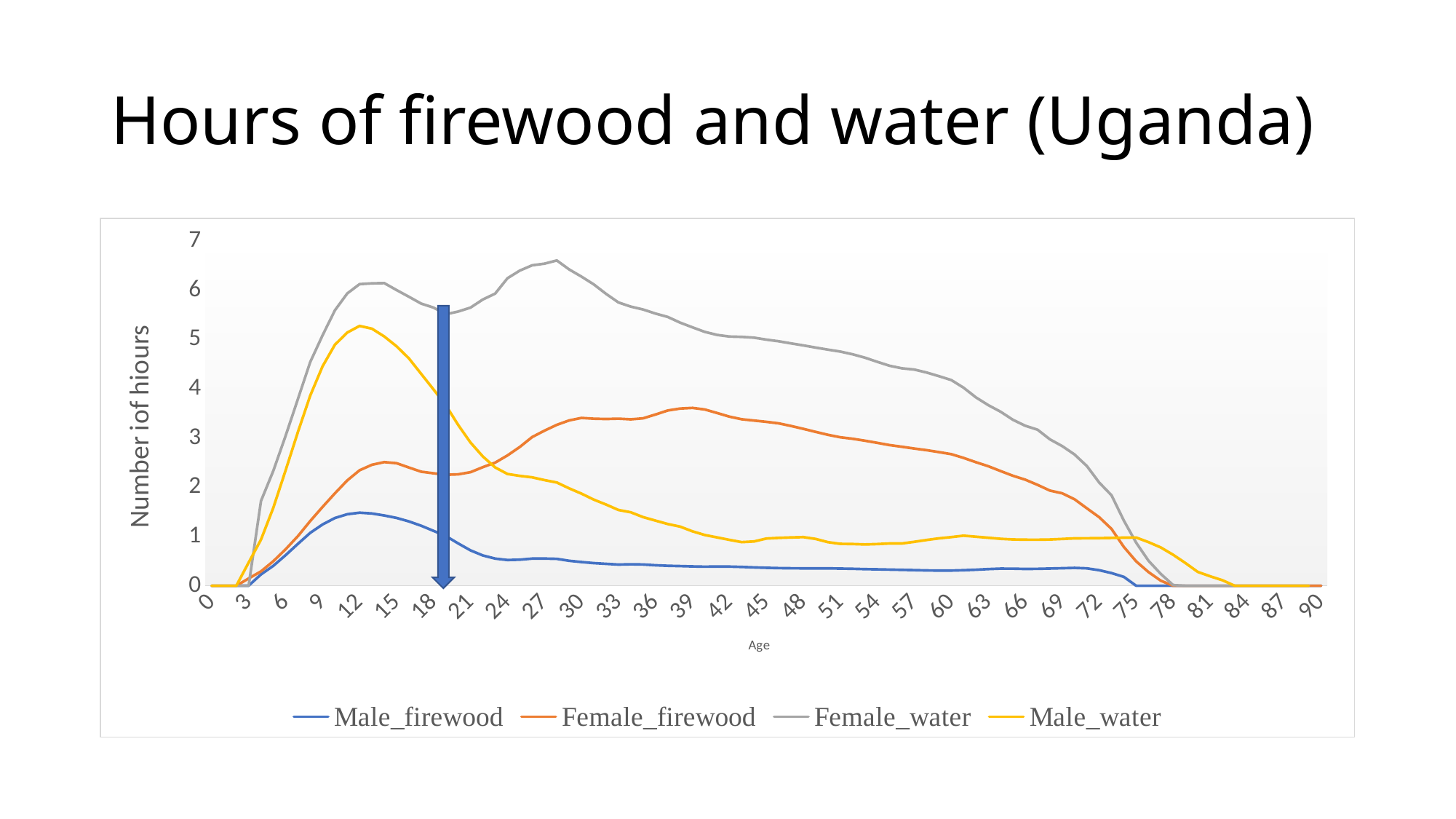
Is the value for Female_firewood at age 60 greater or less than 2? greater Is the value for Female_water at age 27 greater or less than 6? greater What is the title of the slide? Hours of firewood and water (Uganda) At age 12, which is larger: Male_water or Female_firewood? Male_water Does the Female_water line rise or fall between age 30 and age 75? fall At age 39, which is larger: Female_firewood or Male_water? Female_firewood Which series has the lowest value at age 45? Male_firewood What kind of chart is shown on the slide? line chart Which series reaches the highest value on the chart? Female_water How many series does the legend list? 4 Is the value for Male_firewood at age 12 greater or less than 2? less